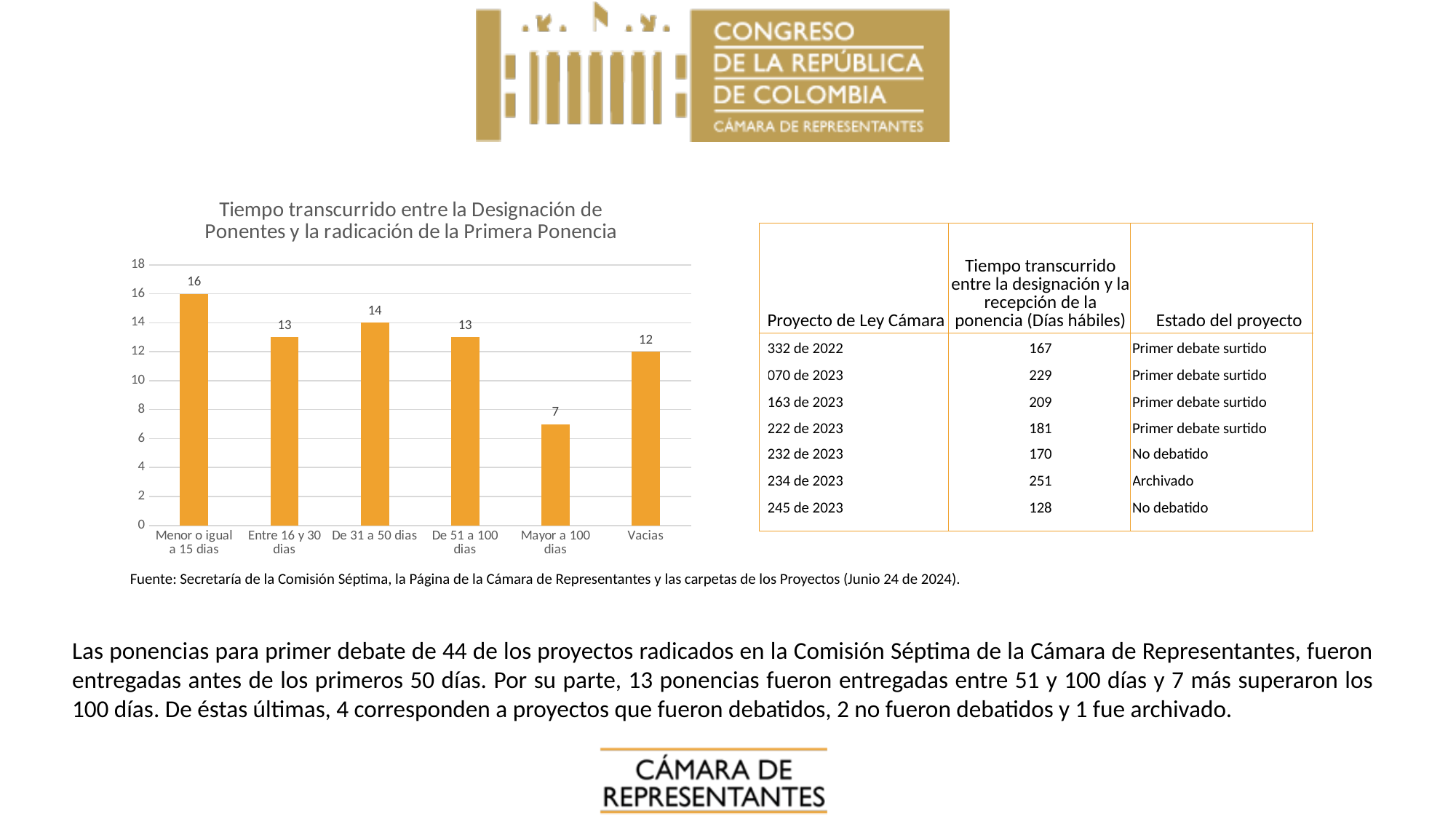
What is the value for 'Vacias'? 12 What is the title of the chart? Tiempo transcurrido entre la Designación de Ponentes y la radicación de la Primera Ponencia What is the value for 'Menor o igual a 15 dias'? 16 What is the difference between the values for 'Menor o igual a 15 dias' and 'Mayor a 100 dias'? 9 How many categories are shown on the x axis? 6 Which category has the lowest value? Mayor a 100 dias Is the value for 'De 51 a 100 dias' greater or less than 10? greater What kind of chart is shown? Bar chart Which is larger, the value for 'Entre 16 y 30 dias' or the value for 'Vacias'? Entre 16 y 30 dias Which category has the highest value? Menor o igual a 15 dias What is the value for 'De 31 a 50 dias'? 14 What is the value for 'Mayor a 100 dias'? 7